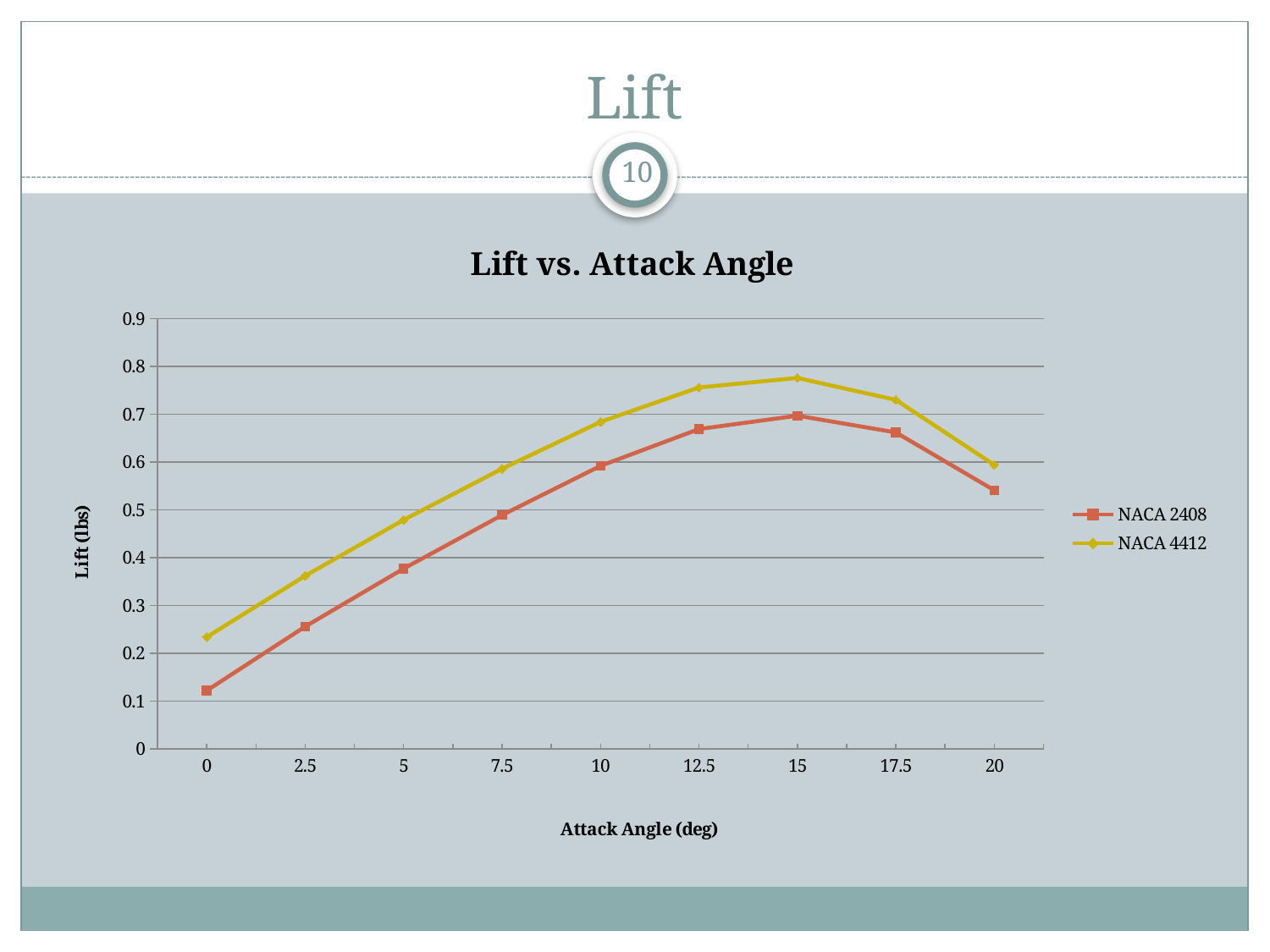
Is the lift for NACA 4412 at 15 degrees greater or less than 0.7? greater At which attack angle does NACA 4412 reach its highest lift? 15 How many attack angle points are plotted for each series? 9 What is the title of the chart? Lift vs. Attack Angle Does the lift for NACA 2408 rise or fall between 15 and 20 degrees? fall At an attack angle of 10 degrees, which series has the higher lift? NACA 4412 What is the title of the x axis? Attack Angle (deg) At which attack angle is the lift for NACA 2408 lowest? 0 At which attack angle does NACA 2408 reach its highest lift? 15 What kind of chart is shown on the slide? line chart How many series does the legend list? 2 Is the lift for NACA 2408 at 0 degrees greater or less than 0.2? less